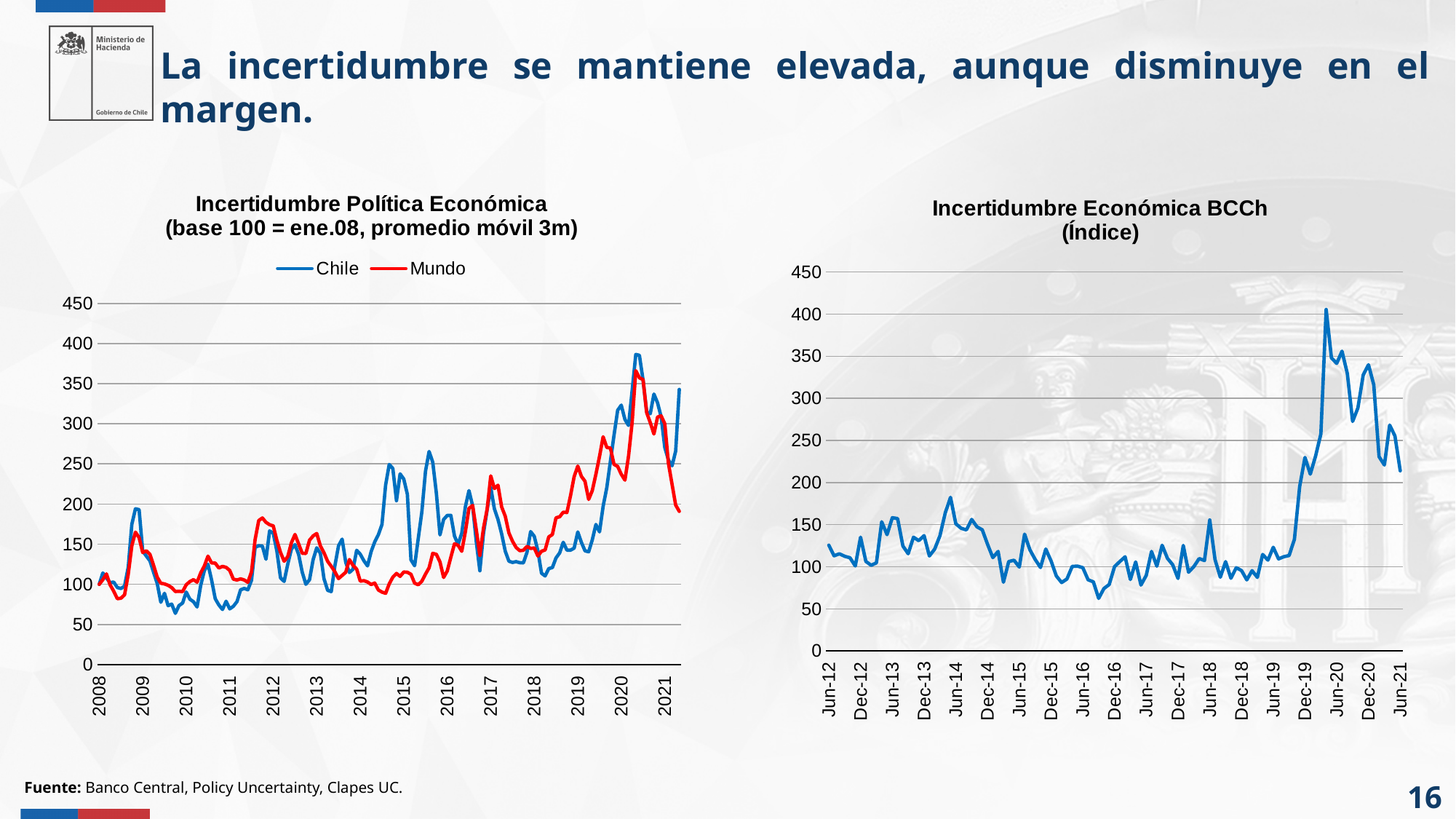
What is the title of the right chart? Incertidumbre Económica BCCh (Índice) In the left chart, 'Incertidumbre Política Económica', which series is drawn in red? Mundo In the left chart, 'Incertidumbre Política Económica', is the value of the Mundo series around 2010 greater or less than 150? less What kind of chart is the left chart, 'Incertidumbre Política Económica'? line chart In the left chart, 'Incertidumbre Política Económica', is the peak value of the Chile series around 2020 greater or less than 350? greater How many series does the legend of the left chart, 'Incertidumbre Política Económica', list? 2 In the right chart, 'Incertidumbre Económica BCCh', do the values rise or fall overall from Jun-20 to Jun-21? fall How many year labels are shown on the x axis of the left chart, 'Incertidumbre Política Económica'? 14 In the right chart, 'Incertidumbre Económica BCCh', is the peak value around Jun-20 greater or less than 350? greater In the left chart, 'Incertidumbre Política Económica', which series is higher around 2015, Chile or Mundo? Chile In the left chart, 'Incertidumbre Política Económica', which series is higher around 2019, Chile or Mundo? Mundo